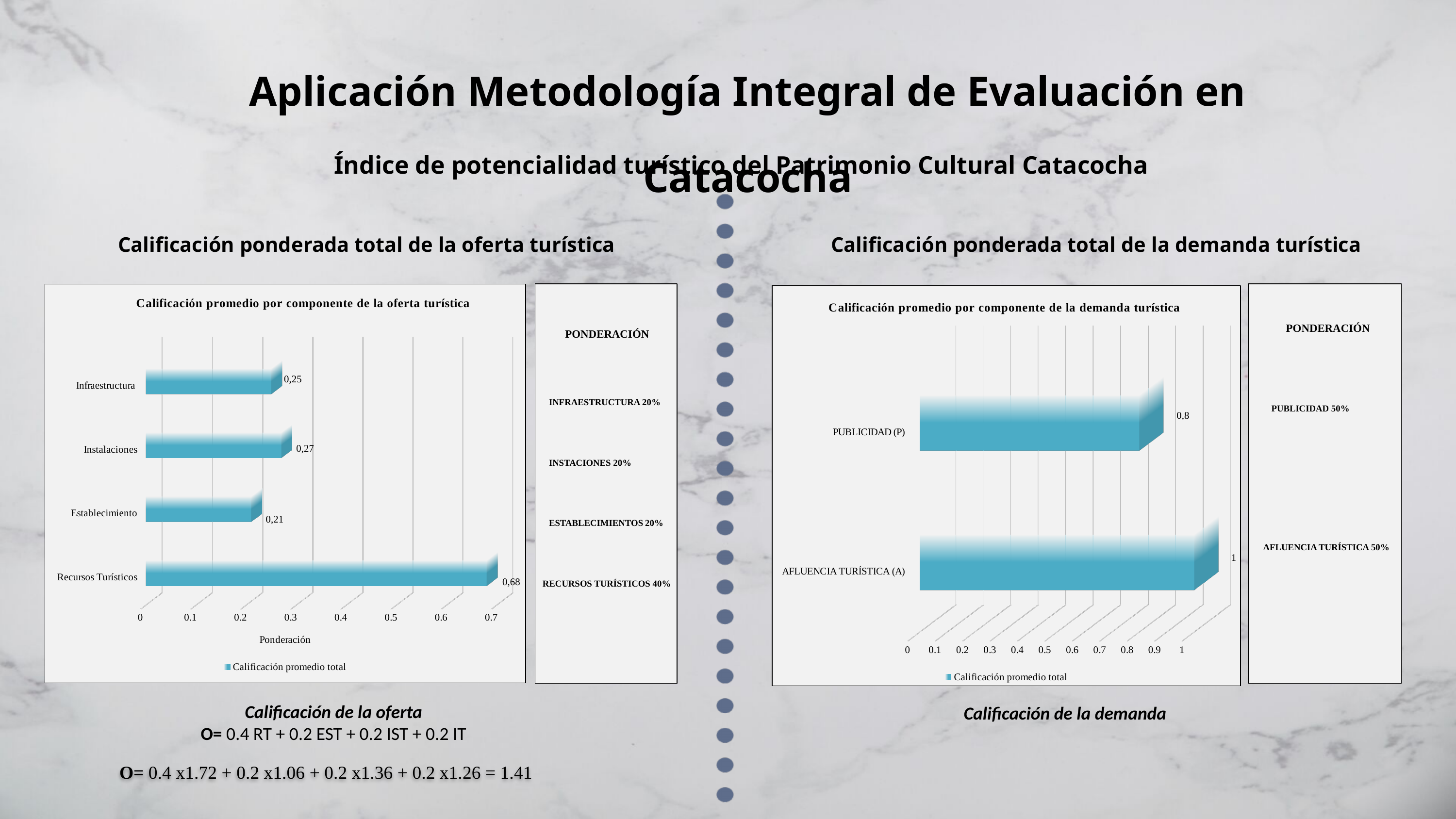
How many categories are shown in the chart 'Calificación promedio por componente de la oferta turística'? 4 In the chart 'Calificación promedio por componente de la demanda turística', what is the value for AFLUENCIA TURÍSTICA (A)? 1 In the chart 'Calificación promedio por componente de la oferta turística', which category has the lowest value? Establecimiento In the chart 'Calificación promedio por componente de la oferta turística', which is larger, Instalaciones or Infraestructura? Instalaciones What is the legend entry shown in the chart 'Calificación promedio por componente de la oferta turística'? Calificación promedio total What kind of chart is 'Calificación promedio por componente de la demanda turística'? Bar chart In the chart 'Calificación promedio por componente de la demanda turística', which category has the higher value? AFLUENCIA TURÍSTICA (A) In the chart 'Calificación promedio por componente de la oferta turística', which category has the highest value? Recursos Turísticos In the chart 'Calificación promedio por componente de la oferta turística', what is the value for Establecimiento? 0,21 In the chart 'Calificación promedio por componente de la oferta turística', what is the value for Recursos Turísticos? 0,68 In the chart 'Calificación promedio por componente de la oferta turística', what is the difference between the values for Recursos Turísticos and Infraestructura? 0,43 In the chart 'Calificación promedio por componente de la demanda turística', what is the value for PUBLICIDAD (P)? 0,8